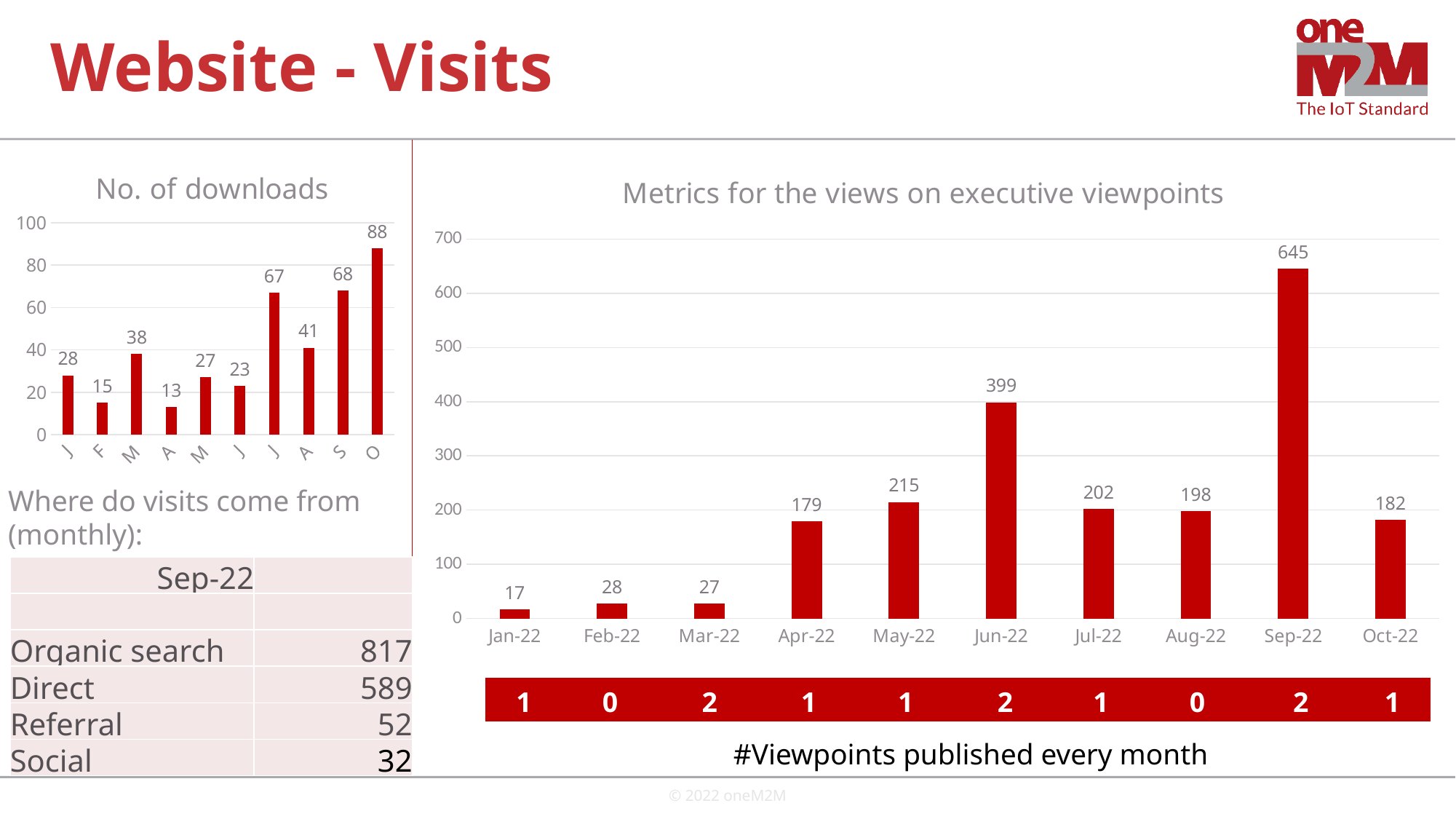
In the 'Metrics for the views on executive viewpoints' chart, which is larger, the value for Jul-22 or Aug-22? Jul-22 In the 'Metrics for the views on executive viewpoints' chart, is the value for Apr-22 greater or less than 200? less In the 'Metrics for the views on executive viewpoints' chart, what is the value for Sep-22? 645 How many months are shown in the 'Metrics for the views on executive viewpoints' chart? 10 In the 'No. of downloads' chart, which bar has the lowest value? A (13) In the 'Metrics for the views on executive viewpoints' chart, which month has the lowest value? Jan-22 In the 'No. of downloads' chart, what is the value for the last bar (O)? 88 In the 'No. of downloads' chart, what is the difference between the values for the bars labelled 88 and 68? 20 In the 'Metrics for the views on executive viewpoints' chart, what is the difference between the values for Jun-22 and May-22? 184 What kind of chart is the 'Metrics for the views on executive viewpoints' chart? bar chart How many bars are in the 'No. of downloads' chart? 10 In the 'Metrics for the views on executive viewpoints' chart, which month has the highest value? Sep-22